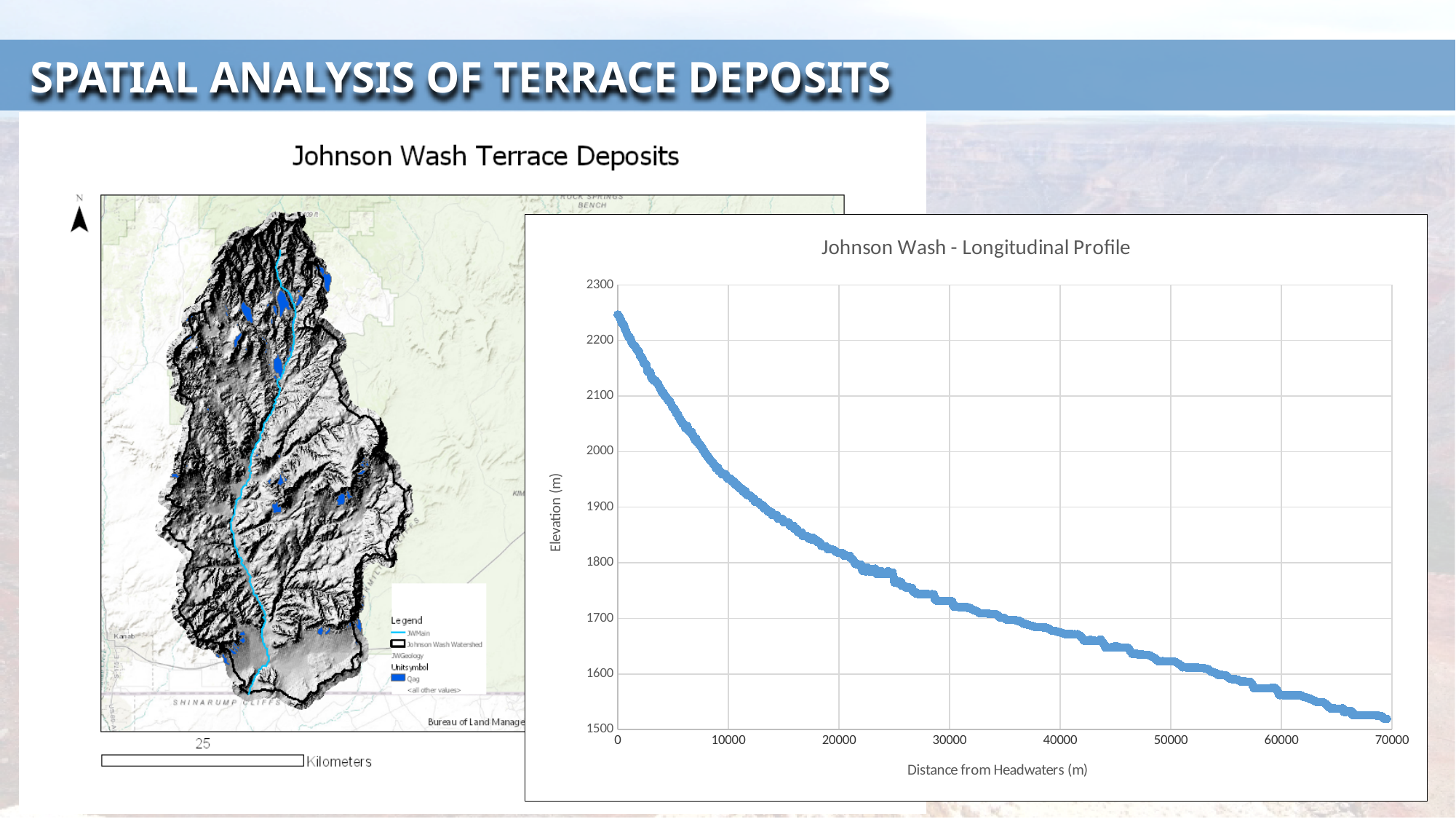
In the Johnson Wash - Longitudinal Profile chart, is the elevation at a distance of 10000 m greater or less than 2000? less In the Johnson Wash - Longitudinal Profile chart, is the elevation at a distance of 50000 m greater or less than 1600? greater In the Johnson Wash - Longitudinal Profile chart, is the elevation at a distance of 20000 m greater or less than 1800? greater In the Johnson Wash - Longitudinal Profile chart, what is the label of the vertical axis? Elevation (m) What is the title of the chart on the right side of the slide? Johnson Wash - Longitudinal Profile In the Johnson Wash - Longitudinal Profile chart, what is the highest value shown on the vertical axis? 2300 In the Johnson Wash - Longitudinal Profile chart, what kind of chart is used to show the data? scatter chart In the Johnson Wash - Longitudinal Profile chart, does elevation rise or fall as distance from the headwaters increases? fall In the Johnson Wash - Longitudinal Profile chart, which has the higher elevation: the point at 0 m or the point at 70000 m from the headwaters? 0 m